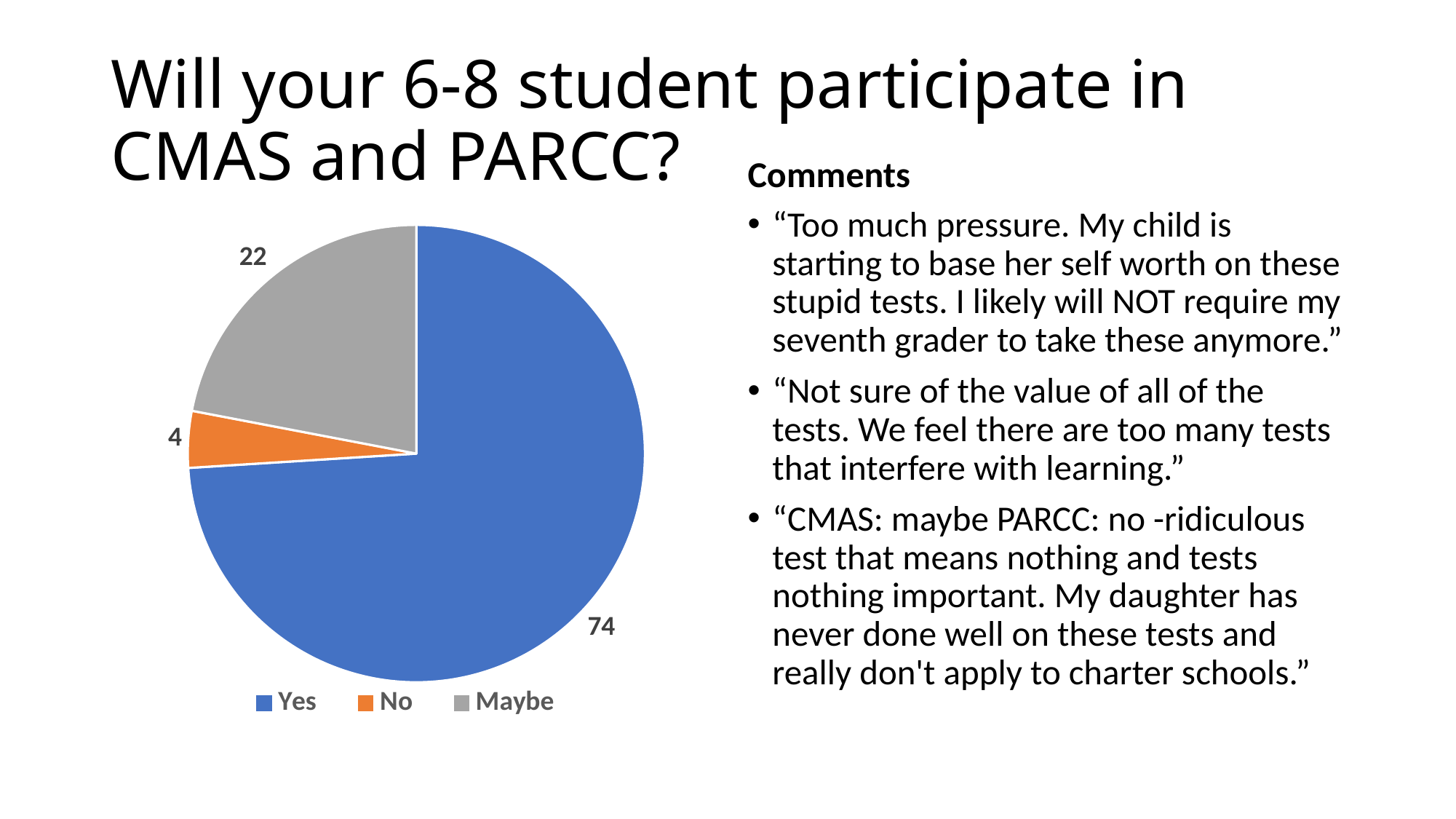
What is the difference between the Yes value and the Maybe value in the pie chart? 52 What value is shown for the No slice of the pie chart? 4 What value is shown for the Yes slice of the pie chart? 74 Which response has the largest slice in the pie chart? Yes Which response has the smallest slice in the pie chart? No What colour is the Maybe slice in the pie chart? Grey What value is shown for the Maybe slice of the pie chart? 22 Which is larger in the pie chart, the Maybe slice or the No slice? Maybe What is the difference between the Maybe value and the No value in the pie chart? 18 What share of the pie chart does the Yes slice represent? 74% What type of chart is shown on the slide? Pie chart How many slices does the pie chart have? 3